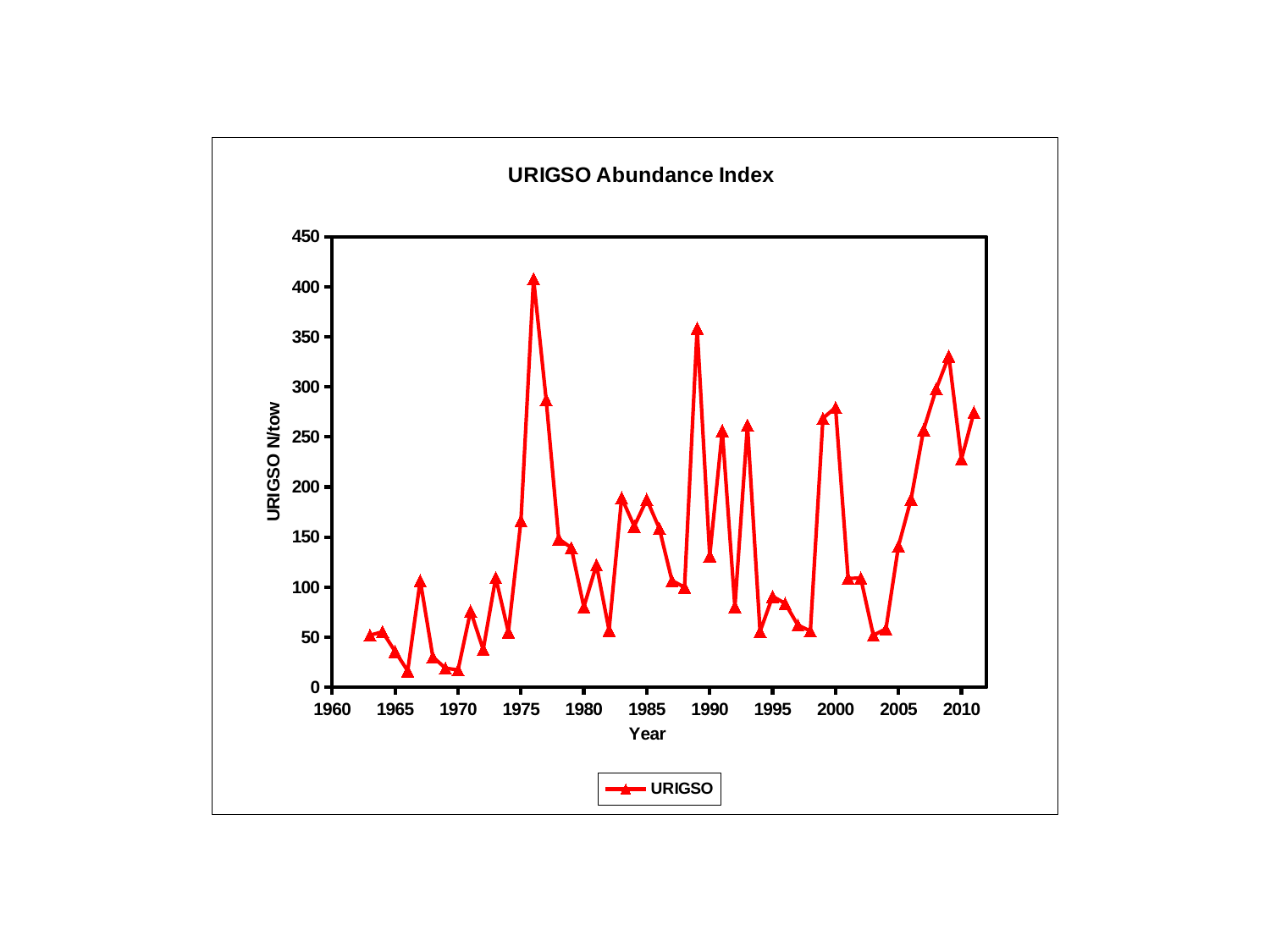
What is the title of the chart? URIGSO Abundance Index Is the value for 2003 greater or less than 100? less Is the value for 1966 greater or less than 50? less Is the value for 1976 greater or less than 350? greater What is the label on the vertical axis of the chart? URIGSO N/tow In which year does the URIGSO series reach its highest value? 1976 Which year has the larger value, 2000 or 2009? 2009 Which year has the larger value, 1976 or 1989? 1976 How many series does the legend list? 1 Do the values rise or fall from 2004 to 2009? rise What kind of chart is shown on the slide? line chart